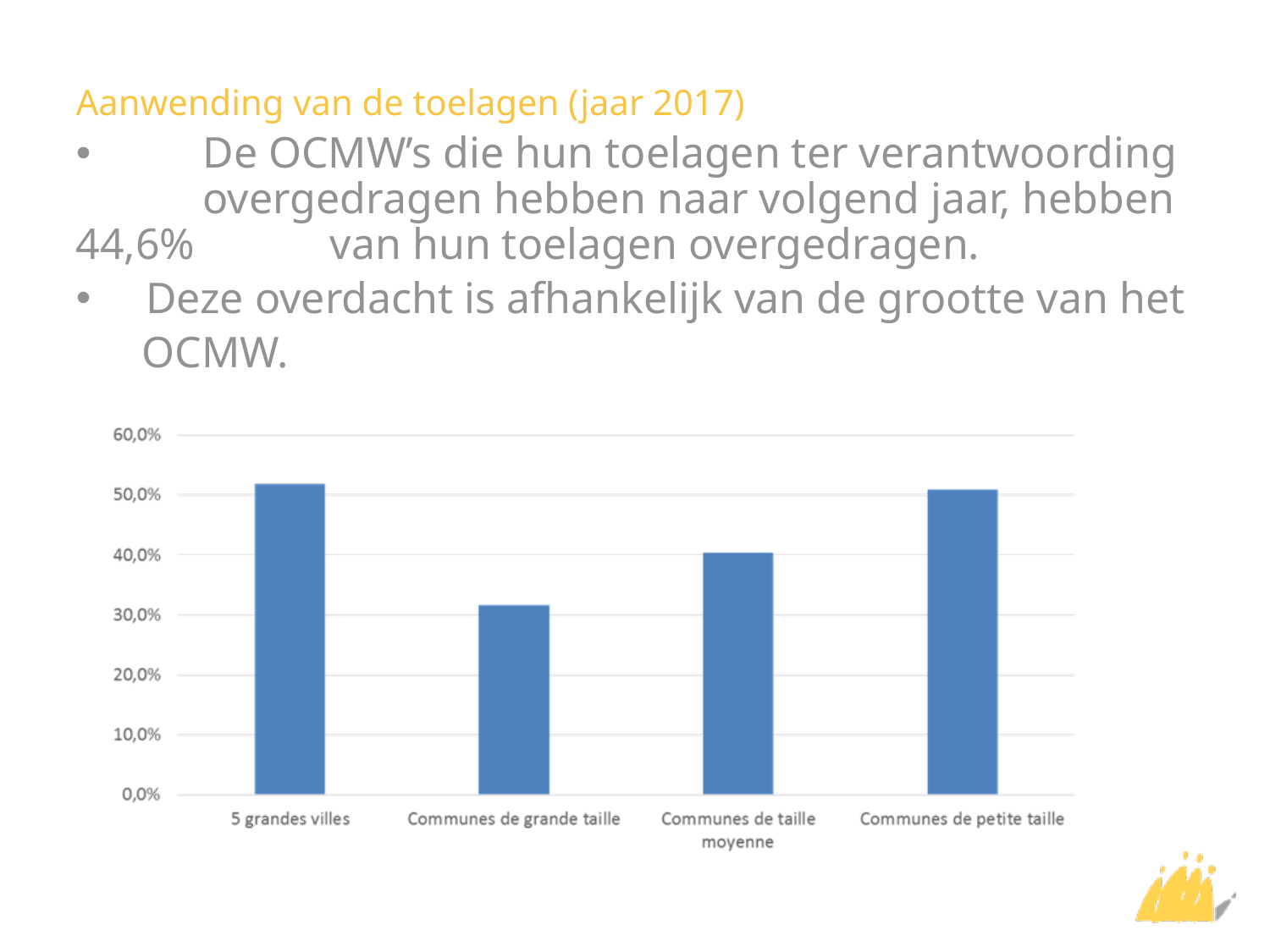
Is the value for Communes de grande taille greater or less than 40,0%? less Which category has the lowest bar in the chart? Communes de grande taille What colour are the bars in the chart? blue What is the highest value shown on the y axis of the chart? 60,0% Is the value for Communes de grande taille greater or less than 30,0%? greater What kind of chart is shown on the slide? bar chart Which is larger, the value for 5 grandes villes or the value for Communes de taille moyenne? 5 grandes villes How many categories are shown on the x axis of the chart? 4 Which is larger, the value for Communes de grande taille or the value for Communes de taille moyenne? Communes de taille moyenne Is the value for 5 grandes villes greater or less than 50,0%? greater